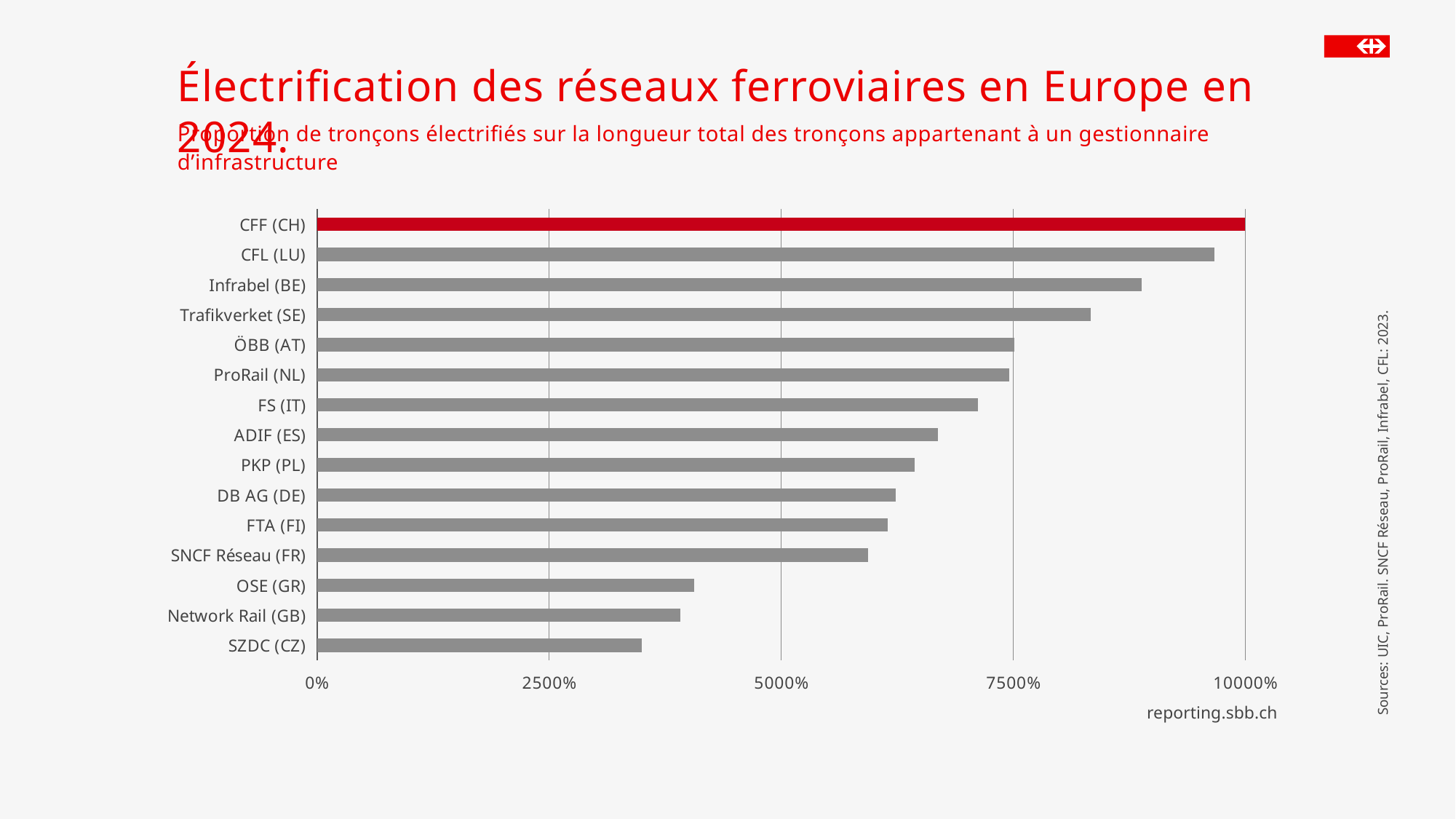
Which bar on the chart is coloured red rather than grey? CFF (CH) Which infrastructure manager has the lowest value on the chart? SZDC (CZ) How many infrastructure managers are listed on the chart? 15 What kind of chart is shown on the slide? bar chart Which infrastructure manager has the highest value on the chart? CFF (CH) What value does the bar for CFF (CH) reach on the axis? 10000% Is the value for FS (IT) greater or less than 7500%? less Is the value for CFL (LU) greater or less than 7500%? greater Is the value for OSE (GR) greater or less than 5000%? less Which has the larger value, Network Rail (GB) or SNCF Réseau (FR)? SNCF Réseau (FR) Which has the larger value, Infrabel (BE) or Trafikverket (SE)? Infrabel (BE)